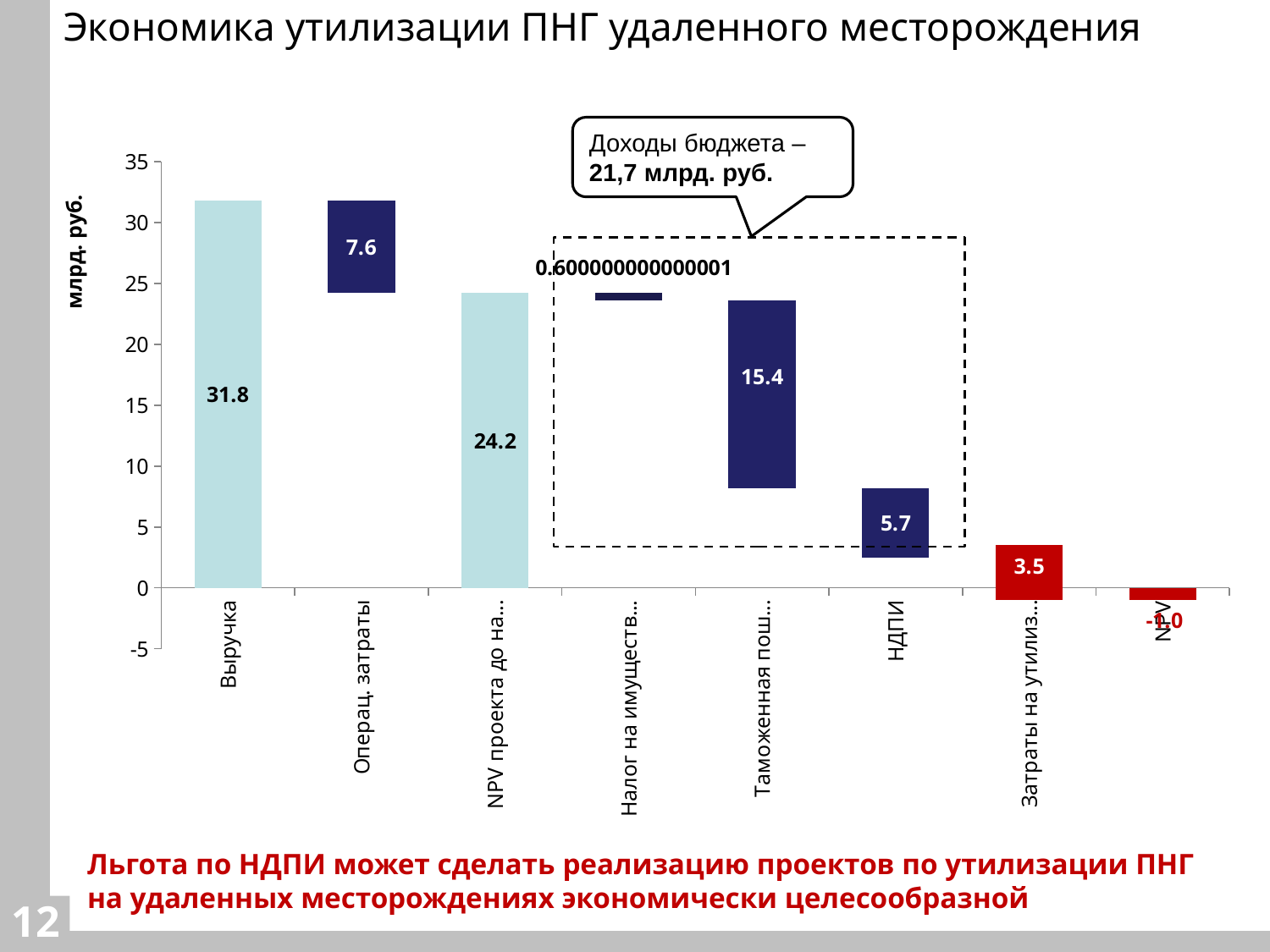
Which category has the lowest value in the chart? NPV Which is larger, the value for НДПИ or the value for Операц. затраты? Операц. затраты What value is labelled on the final NPV bar? -1.0 What unit is shown on the y axis of the chart? млрд. руб. What is the value of the Операц. затраты bar? 7.6 How many categories are shown on the x axis? 8 What kind of chart is shown on the slide? bar chart What is the difference between the Выручка value and the Операц. затраты value? 24.2 What is the value shown for НДПИ? 5.7 Which category has the highest value in the chart? Выручка What is the value labelled on the Таможенная пош… bar? 15.4 What is the value of the Выручка bar? 31.8